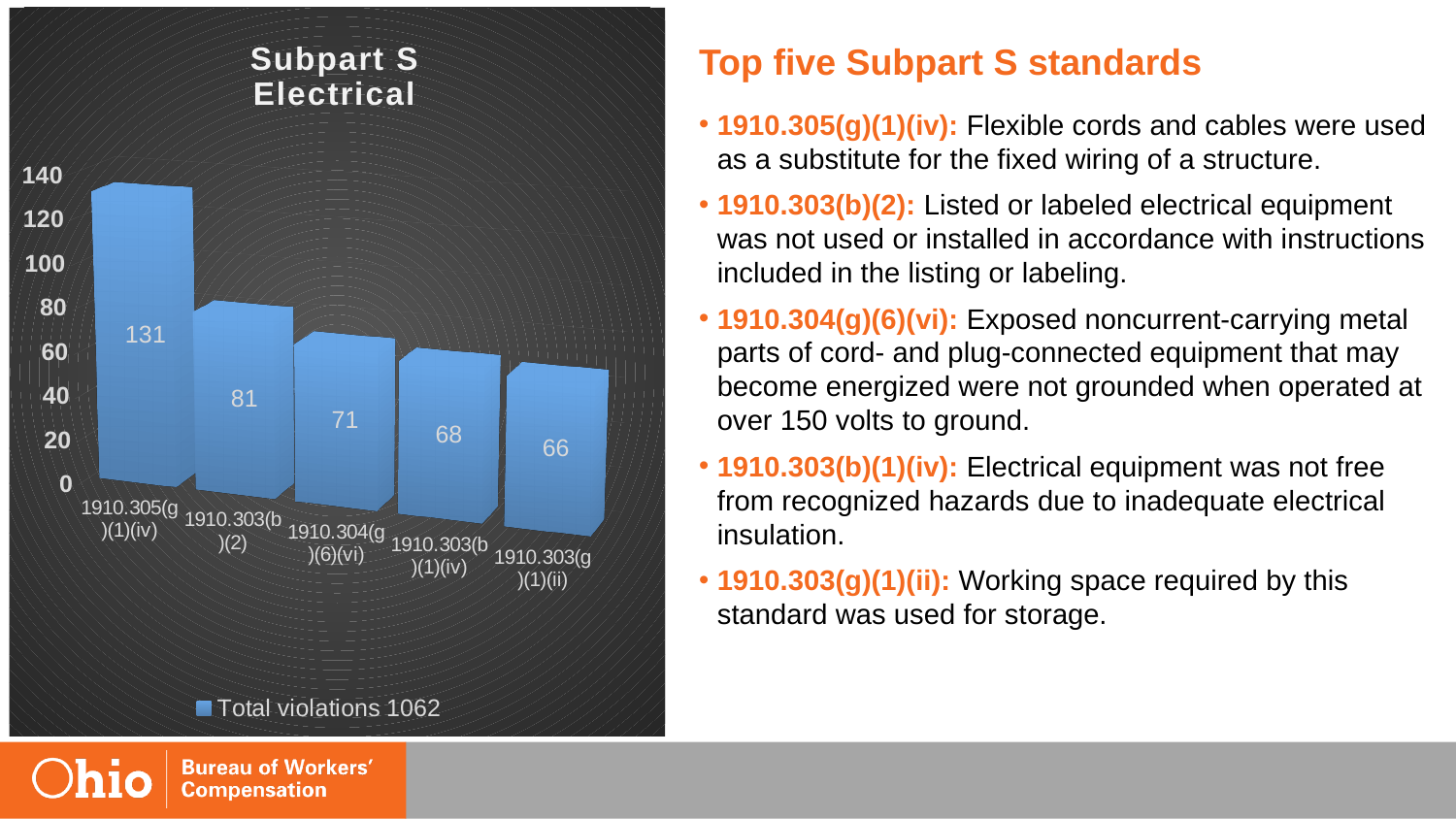
What is the legend entry shown below the Subpart S Electrical chart? Total violations 1062 Which category has the lowest value in the Subpart S Electrical chart? 1910.303(g)(1)(ii) What is the value for 1910.304(g)(6)(vi) in the Subpart S Electrical chart? 71 Do the values rise or fall from left to right across the Subpart S Electrical chart? Fall What is the value for 1910.303(b)(2) in the Subpart S Electrical chart? 81 What is the value for 1910.303(g)(1)(ii) in the Subpart S Electrical chart? 66 Which is larger, the value for 1910.303(b)(1)(iv) or the value for 1910.303(g)(1)(ii)? 1910.303(b)(1)(iv) How many categories are shown in the Subpart S Electrical chart? 5 Which category has the highest value in the Subpart S Electrical chart? 1910.305(g)(1)(iv) What is the value for 1910.305(g)(1)(iv) in the Subpart S Electrical chart? 131 What is the difference between the values for 1910.305(g)(1)(iv) and 1910.303(b)(2)? 50 What kind of chart is shown on the slide? Bar chart